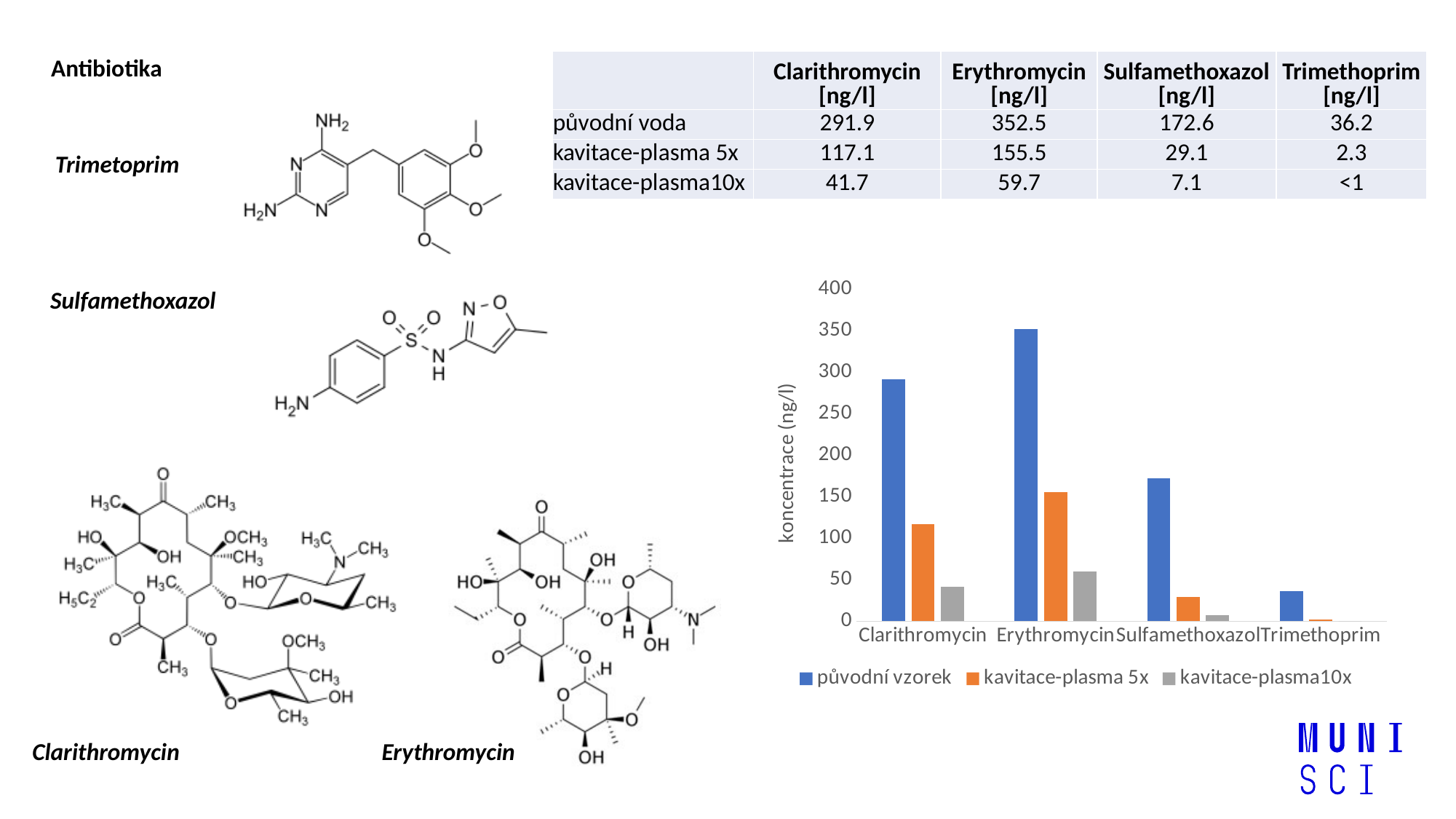
How many antibiotic categories are shown on the x axis of the chart? 4 How many series does the chart legend list? 3 Which is larger, the kavitace-plasma 5x value for Erythromycin or for Clarithromycin? Erythromycin What colour are the bars for the kavitace-plasma 5x series? orange Is the původní vzorek value for Erythromycin greater or less than 300? greater What kind of chart is shown on the slide? bar chart Which antibiotic has the lowest bar for the původní vzorek series? Trimethoprim What is the label of the y axis of the chart? koncentrace (ng/l) Is the kavitace-plasma10x value for Erythromycin greater or less than 100? less Is the kavitace-plasma 5x value for Sulfamethoxazol greater or less than 50? less Which antibiotic has the highest bar for the původní vzorek series? Erythromycin